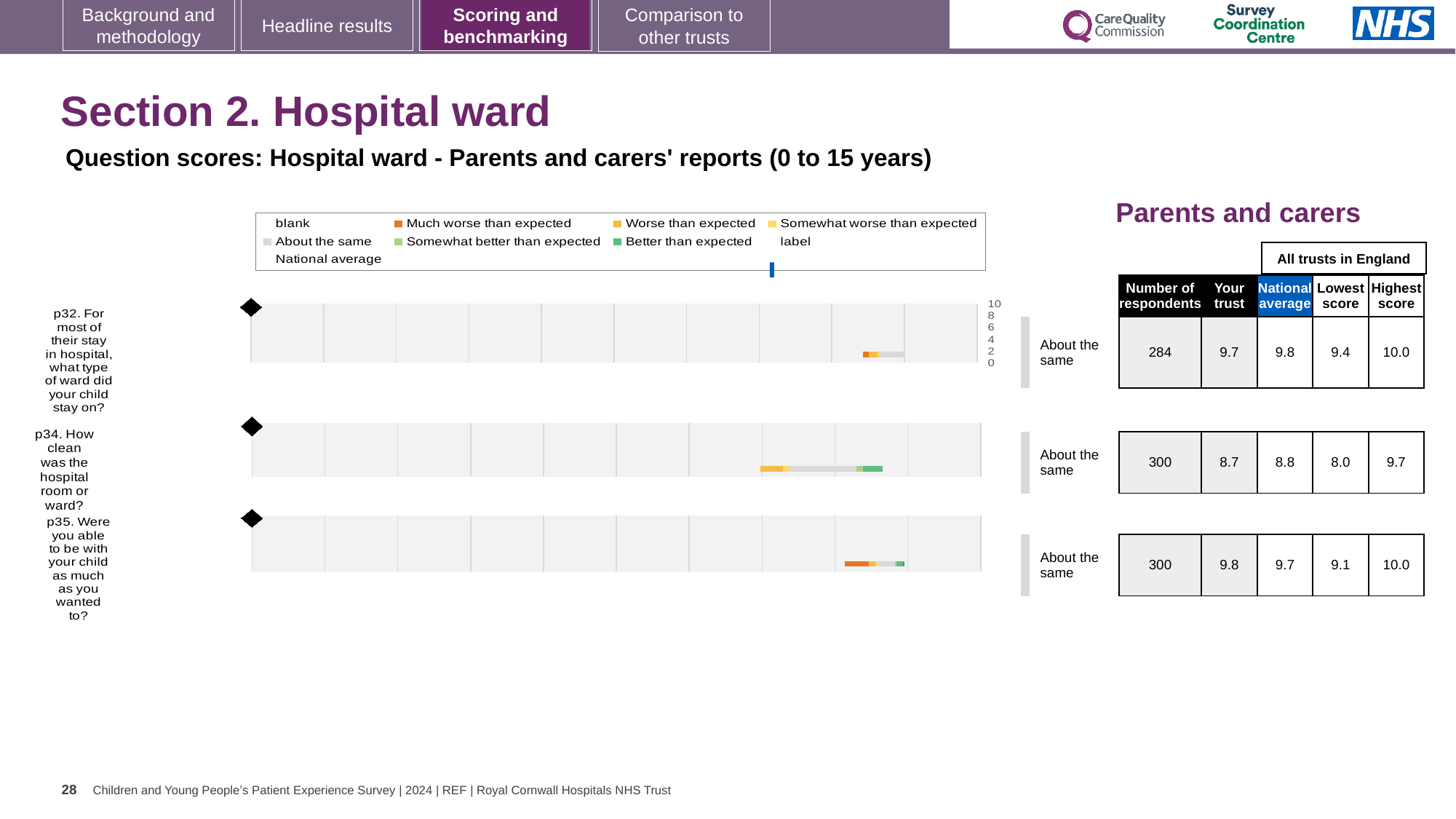
How many respondents are listed for p32? 284 What benchmark category is shown next to each of the three question charts? About the same For p35 (Were you able to be with your child as much as you wanted to?), which is larger: the 'Your trust' score or the national average? Your trust What colour does the legend use for 'Better than expected'? Green What is the highest score across all trusts in England for p34? 9.7 What is the difference between the highest score and the lowest score for p34? 1.7 Which question has the highest 'Your trust' score? p35 What kind of chart is used for each question on the slide? Bar chart What is the national average score for p32 (For most of their stay in hospital, what type of ward did your child stay on?)? 9.8 Which question has the lowest 'Your trust' score? p34 What is the 'Your trust' score for p34 (How clean was the hospital room or ward?)? 8.7 How many question charts are shown on the slide? 3